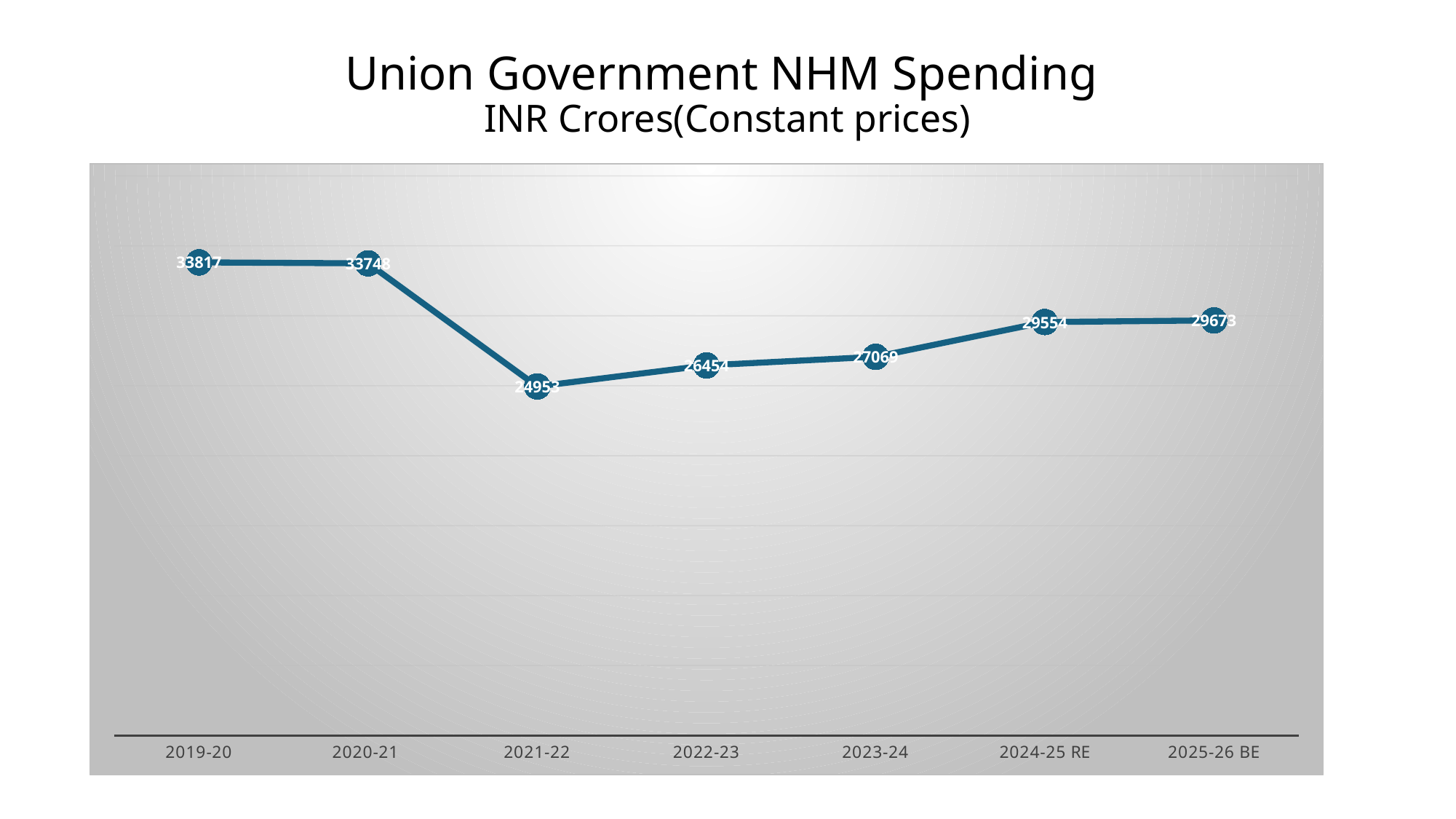
How many years are plotted on the chart? 7 What is the difference between the NHM spending in 2020-21 and 2021-22? 8795 What unit is given in the chart's subtitle? INR Crores(Constant prices) What is the NHM spending value for 2021-22? 24953 What is the NHM spending value for 2019-20? 33817 Which year has the lowest NHM spending? 2021-22 What is the NHM spending value for 2024-25 RE? 29554 What kind of chart is shown on the slide? Line chart Does NHM spending rise or fall from 2021-22 to 2025-26 BE? Rise What is the difference between the NHM spending in 2025-26 BE and 2024-25 RE? 119 Which year has the highest NHM spending? 2019-20 Which is larger, the NHM spending in 2022-23 or in 2023-24? 2023-24